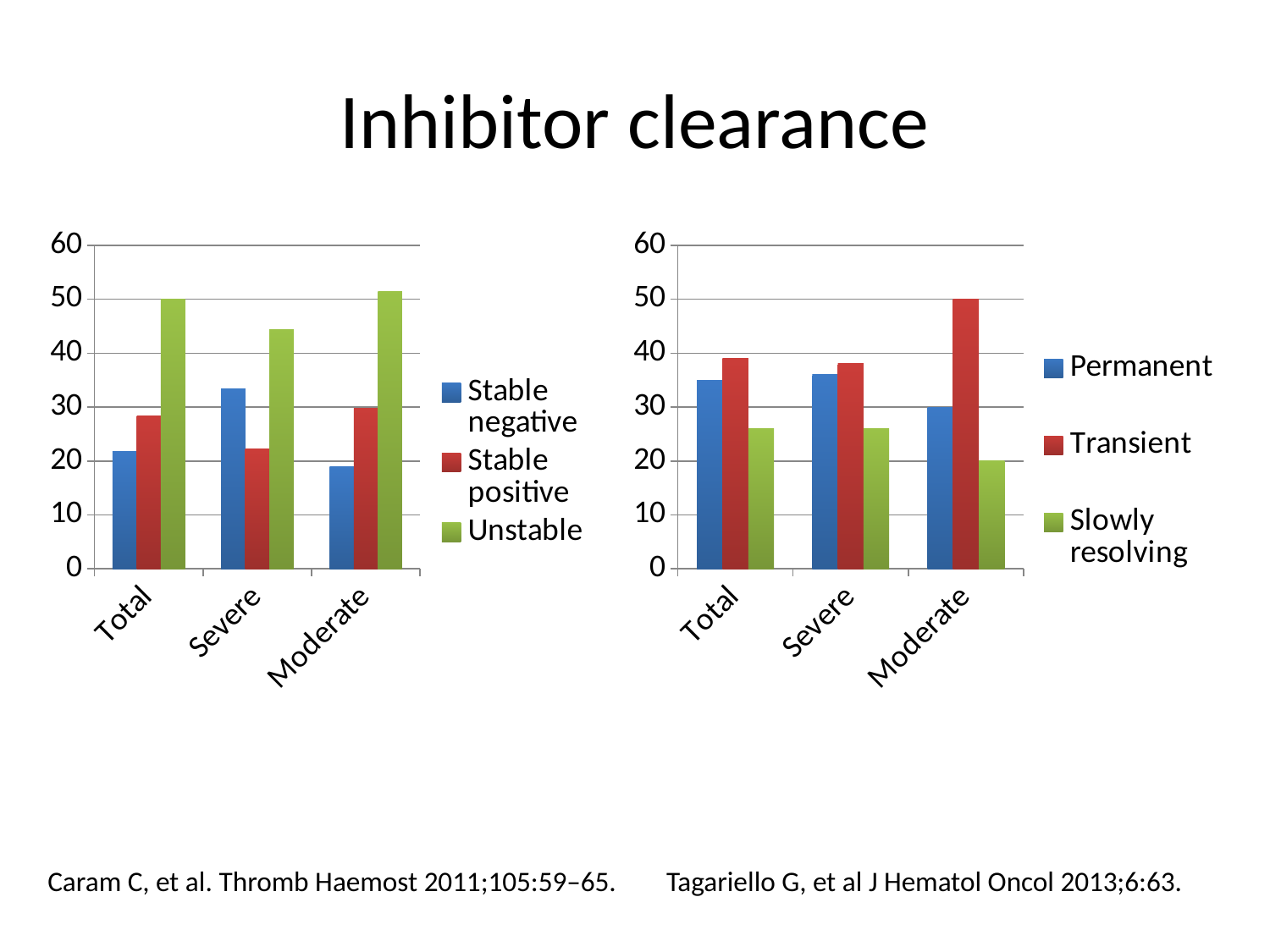
How many categories are shown on the x axis of the right chart? 3 How many series does the legend of the left chart list? 3 In the right chart, which is larger for Total: Permanent or Transient? Transient In the right chart, which series has the highest value for Moderate? Transient In the right chart, is the Slowly resolving value for Moderate greater or less than 25? less In the left chart, is the Stable positive value for Severe greater or less than 30? less In the left chart, which series has the highest value for Total? Unstable In the left chart, is the Stable negative value for Severe greater or less than 30? greater In the left chart, which category has the lowest Unstable value? Severe What kind of chart is the left chart on the slide? bar chart What are the legend entries of the right chart? Permanent, Transient, Slowly resolving